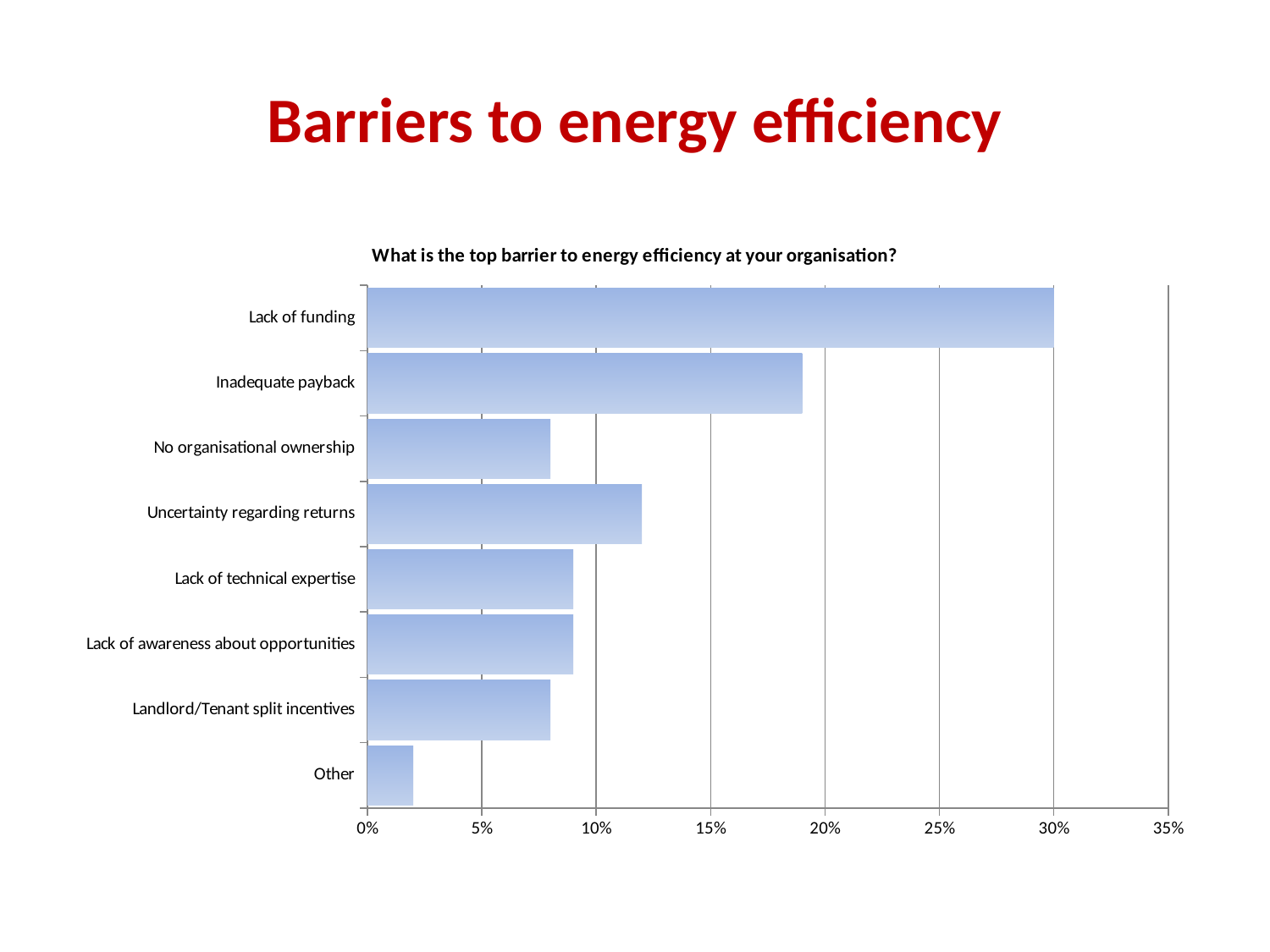
Is the value for No organisational ownership greater or less than 10%? less Which barrier has the highest value? Lack of funding What is the value for Lack of funding? 30% Which is larger, the value for Inadequate payback or the value for Uncertainty regarding returns? Inadequate payback Is the value for Inadequate payback greater or less than 15%? greater Which is larger, the value for Landlord/Tenant split incentives or the value for Other? Landlord/Tenant split incentives Is the value for Uncertainty regarding returns greater or less than 10%? greater How many barrier categories are plotted in the chart? 8 What type of chart is shown on the slide? Bar chart What is the title of the chart? What is the top barrier to energy efficiency at your organisation? Which barrier has the lowest value? Other